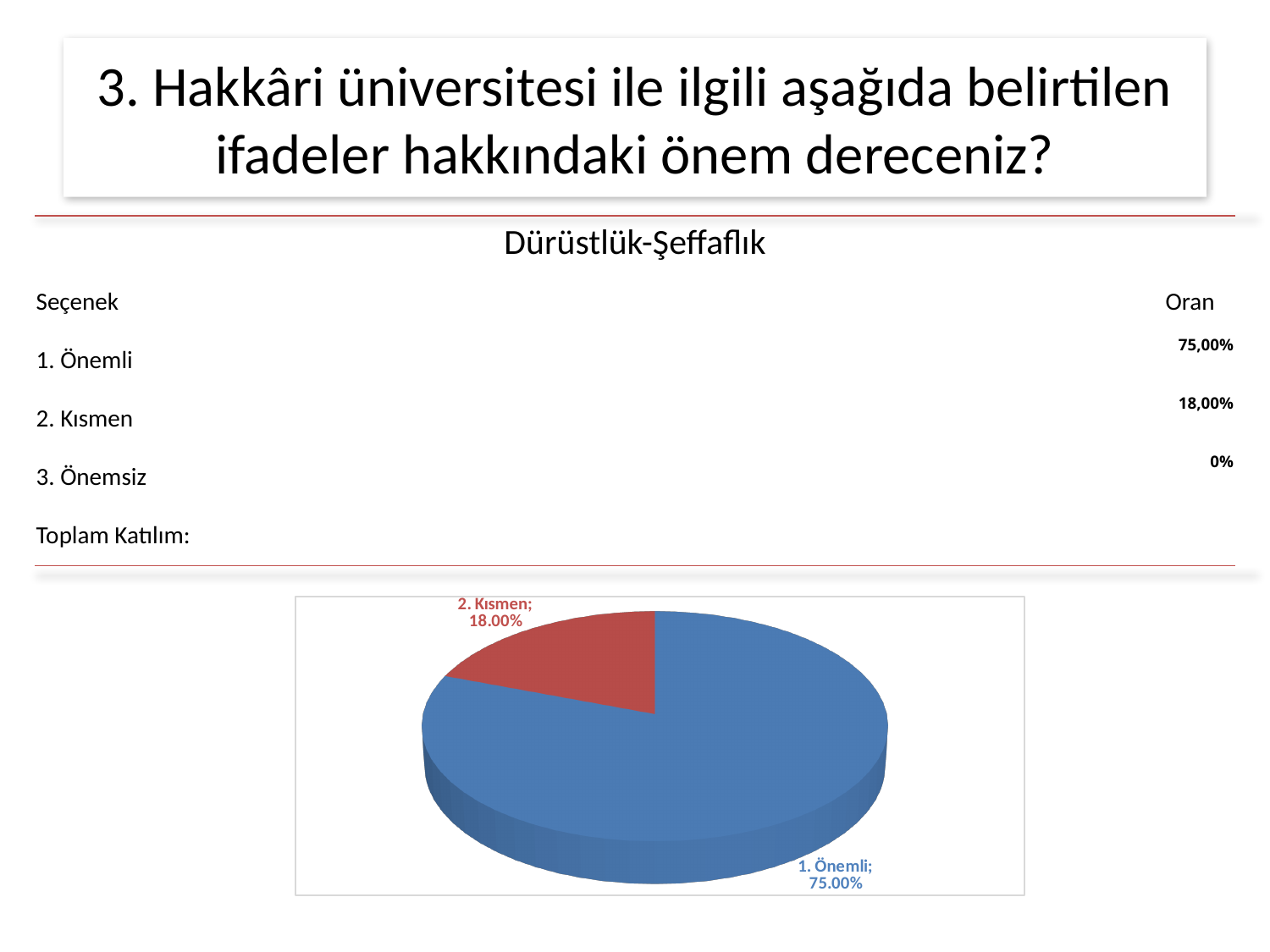
What percentage does the pie chart show for "1. Önemli"? 75.00% What kind of chart is shown on the slide? pie chart Which is larger in the pie chart, "1. Önemli" or "2. Kısmen"? 1. Önemli Which labeled slice in the pie chart is the smallest? 2. Kısmen What share of the pie does the "2. Kısmen" slice represent? 18.00% What colour is the "2. Kısmen" slice in the pie chart? red What colour is the "1. Önemli" slice in the pie chart? blue Which category has the largest slice in the pie chart? 1. Önemli How many labeled slices does the pie chart have? 2 What is the difference between the "1. Önemli" and "2. Kısmen" slices in the pie chart? 57.00% What percentage does the pie chart show for "2. Kısmen"? 18.00%